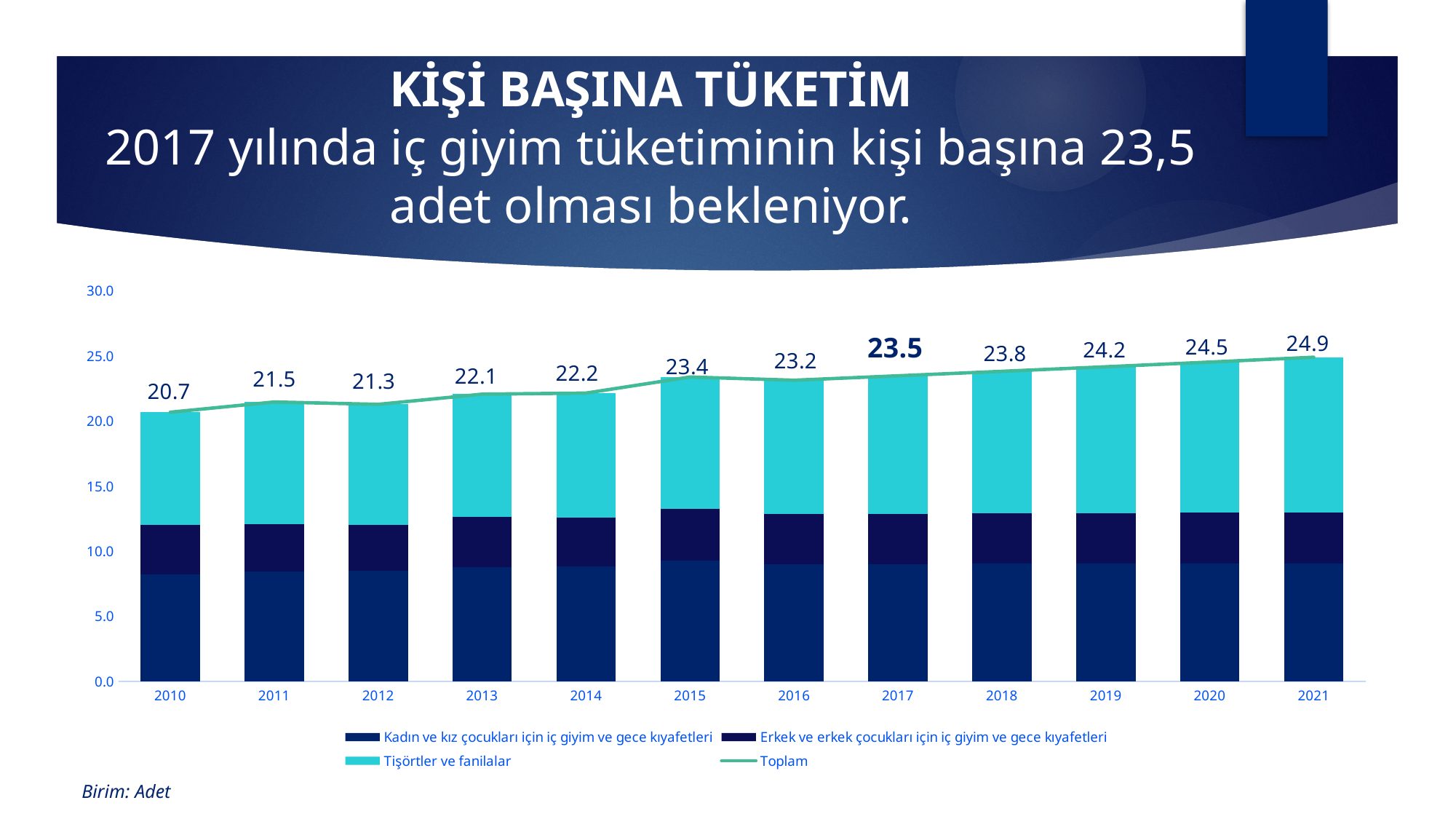
Do the total values generally rise or fall from 2010 to 2021? Rise What is the total value shown for 2010? 20.7 Which year has the highest total value? 2021 Which year has a larger total value, 2015 or 2016? 2015 Is the value of the 'Kadın ve kız çocukları için iç giyim ve gece kıyafetleri' segment for 2010 greater or less than 10.0? less Which year has the lowest total value? 2010 What is the difference between the total values for 2021 and 2010? 4.2 What is the total (Toplam) value for 2017? 23.5 How many series does the legend list? 4 What kind of chart is shown on the slide? Stacked bar chart with a line How many years are shown on the x axis? 12 What is the total value shown for 2021? 24.9